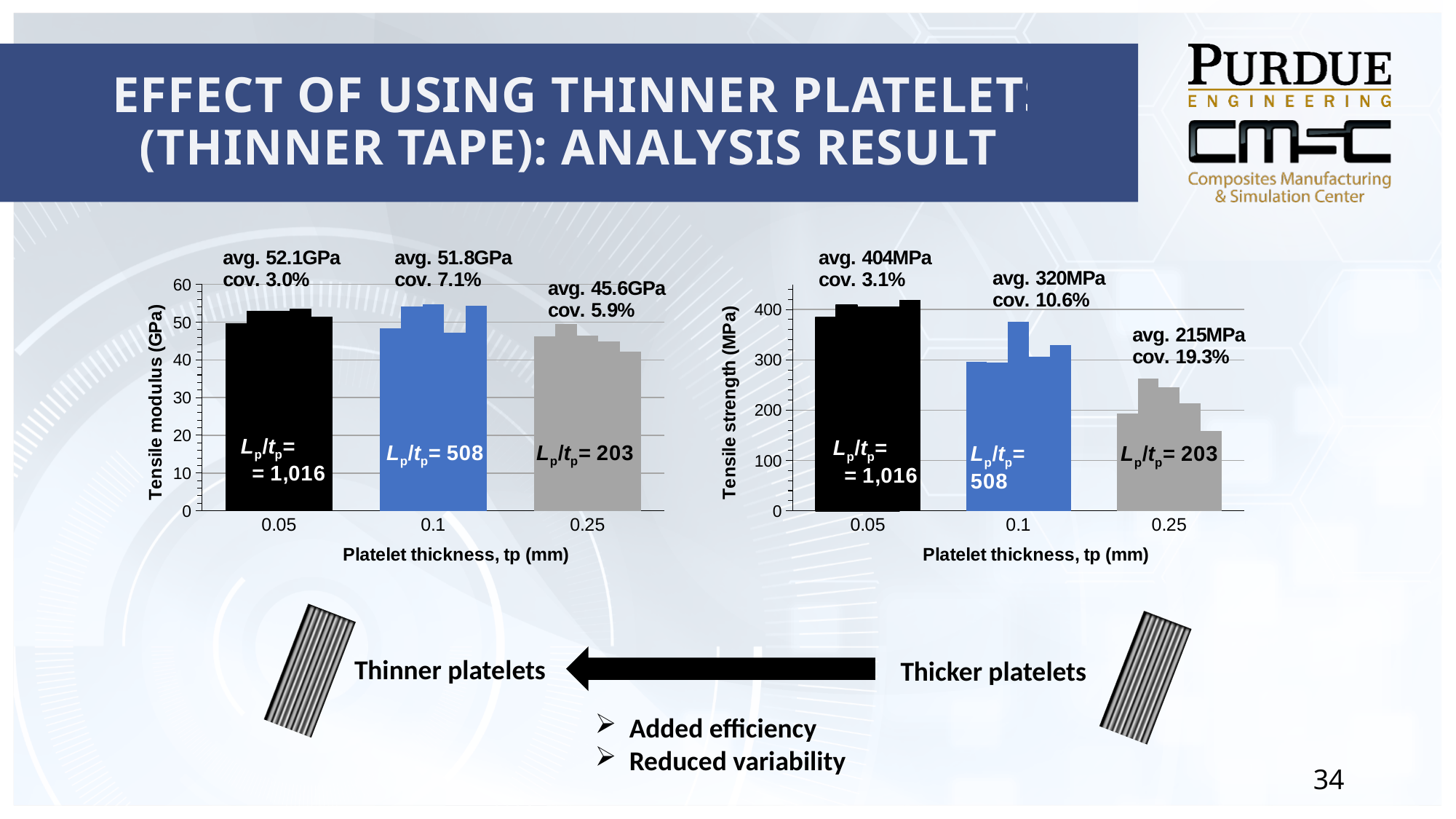
In the right chart (Tensile strength), are the bars for platelet thickness 0.25 mm greater or less than 300? less In the left chart (Tensile modulus), what is the difference between the average tensile modulus at 0.05 mm and at 0.25 mm? 6.5GPa How many platelet thickness categories are shown on the x axis of the left chart (Tensile modulus)? 3 In the left chart (Tensile modulus), what is the average tensile modulus for platelet thickness 0.05 mm? 52.1GPa In the left chart (Tensile modulus), which platelet thickness has the lowest average tensile modulus? 0.25 In the right chart (Tensile strength), what is the coefficient of variation (cov.) for platelet thickness 0.25 mm? 19.3% In the right chart (Tensile strength), does the average tensile strength rise or fall as platelet thickness increases along the x axis? fall In the right chart (Tensile strength), is the average tensile strength at 0.1 mm larger or smaller than at 0.25 mm? larger In the right chart (Tensile strength), what is the average tensile strength for platelet thickness 0.1 mm? 320MPa In the right chart (Tensile strength), what is the difference between the average tensile strength at 0.05 mm and at 0.25 mm? 189MPa In the left chart (Tensile modulus), what is the coefficient of variation (cov.) for platelet thickness 0.1 mm? 7.1% In the right chart (Tensile strength), which platelet thickness has the highest average tensile strength? 0.05